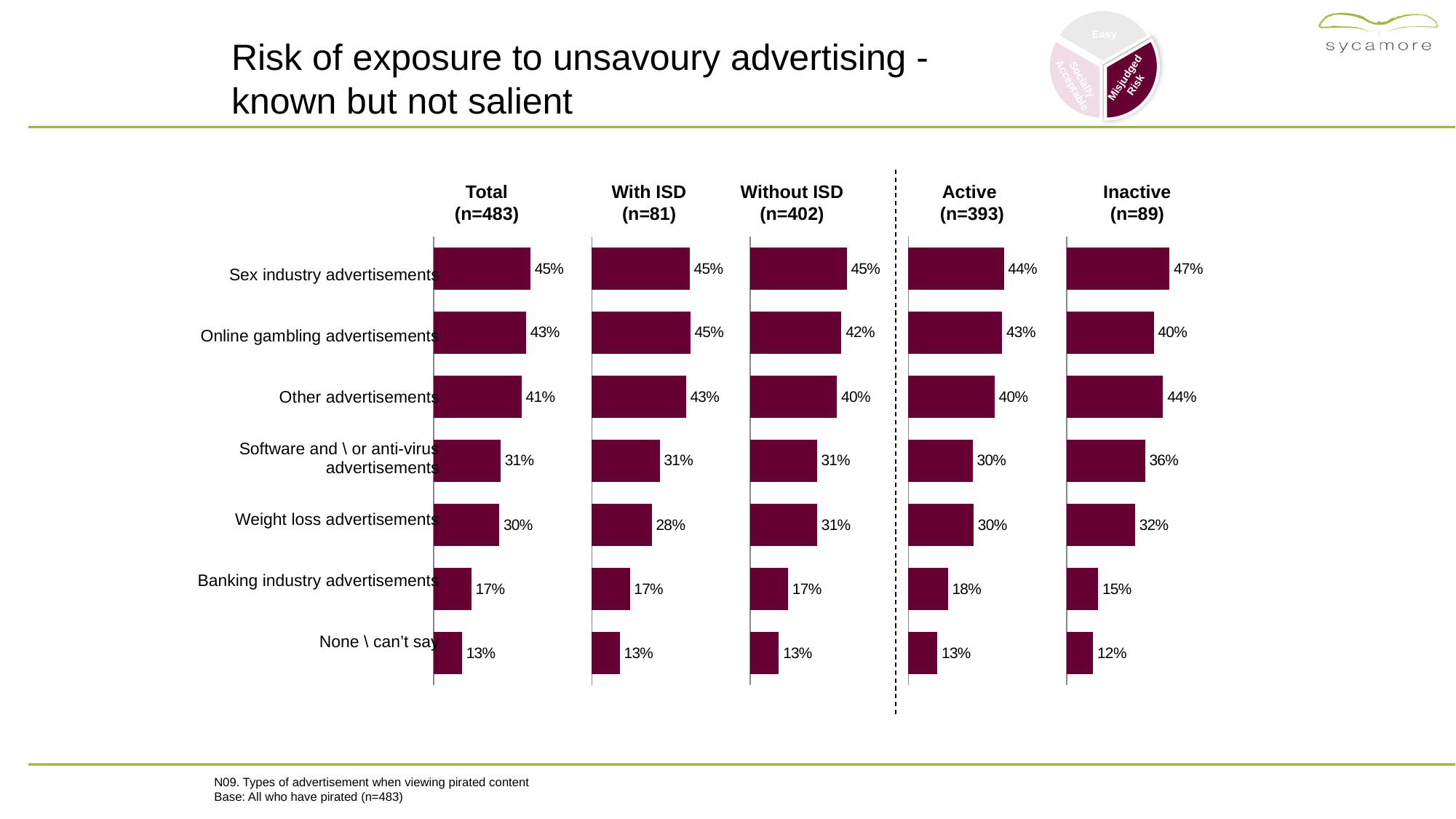
In the With ISD (n=81) chart, what is the value for Weight loss advertisements? 28% How many categories are shown in the Total (n=483) chart? 7 In the Inactive (n=89) chart, which is larger: Other advertisements or Online gambling advertisements? Other advertisements In the Active (n=393) chart, what is the difference between Online gambling advertisements and Weight loss advertisements? 13% In the Total (n=483) chart, what is the value for Sex industry advertisements? 45% What kind of chart is used to show the Total (n=483) data? Bar chart In the With ISD (n=81) chart, which is larger: Other advertisements or Software and \ or anti-virus advertisements? Other advertisements In the Without ISD (n=402) chart, what is the difference between Sex industry advertisements and Banking industry advertisements? 28% In the Inactive (n=89) chart, what is the value for Software and \ or anti-virus advertisements? 36% In the Active (n=393) chart, which category has the lowest value? None \ can't say In the Inactive (n=89) chart, which category has the highest value? Sex industry advertisements How many separate charts (sample groups) are shown on the slide? 5